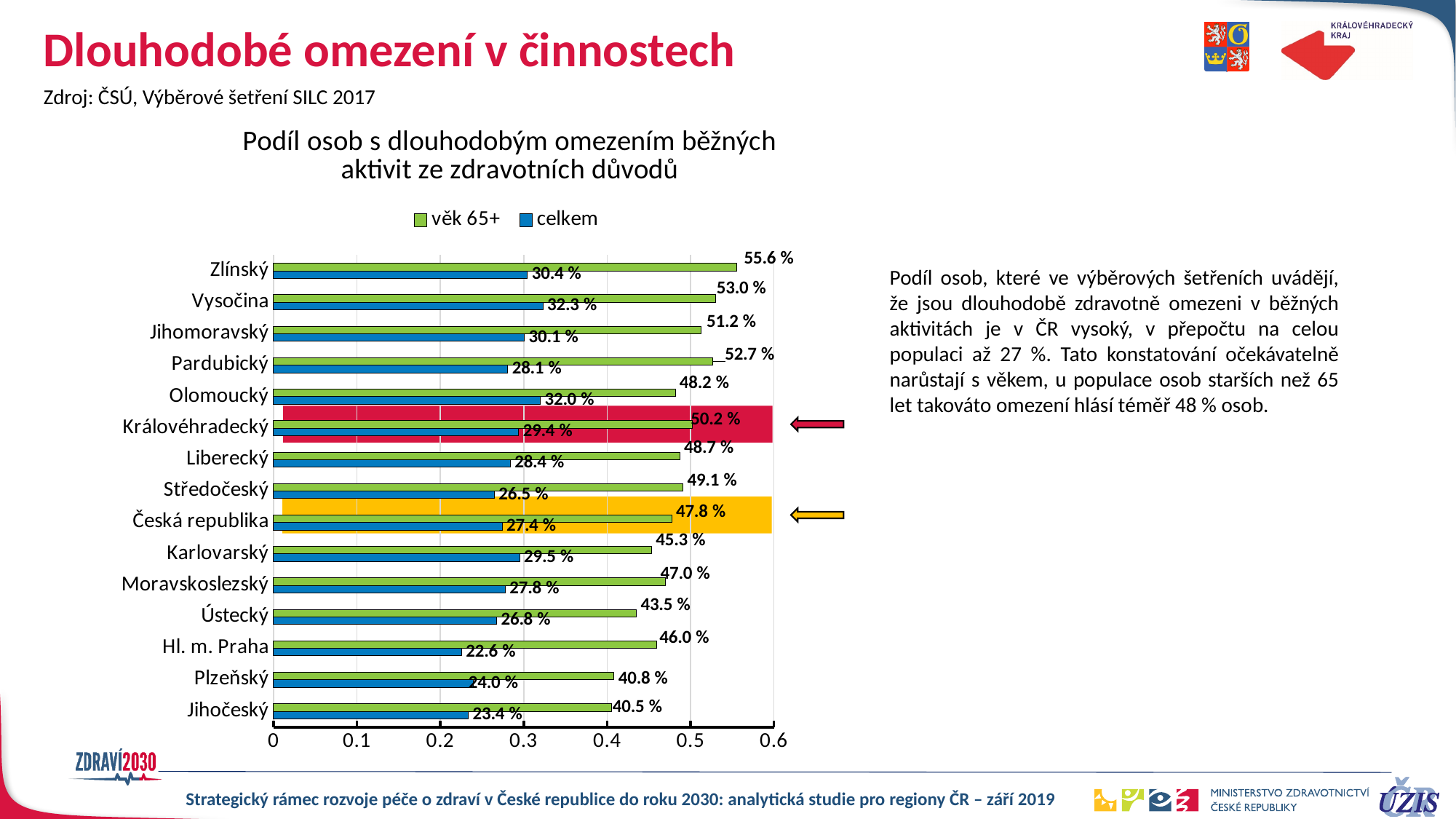
What is the value for 'věk 65+' for Královéhradecký? 50.2 % Which category has the lowest value for 'celkem'? Hl. m. Praha What is the difference between the 'věk 65+' and 'celkem' values for Zlínský? 25.2 % Which two series are listed in the chart legend? věk 65+ and celkem How many series does the legend list? 2 What is the difference between the 'věk 65+' value for Královéhradecký and for Česká republika? 2.4 % What is the value for 'celkem' for Česká republika? 27.4 % Which region has the highest value for 'věk 65+'? Zlínský What type of chart is shown on the slide? bar chart How many categories (regions) are shown on the chart? 15 Which is larger: the 'věk 65+' value for Pardubický or for Olomoucký? Pardubický What is the value for 'celkem' for Hl. m. Praha? 22.6 %